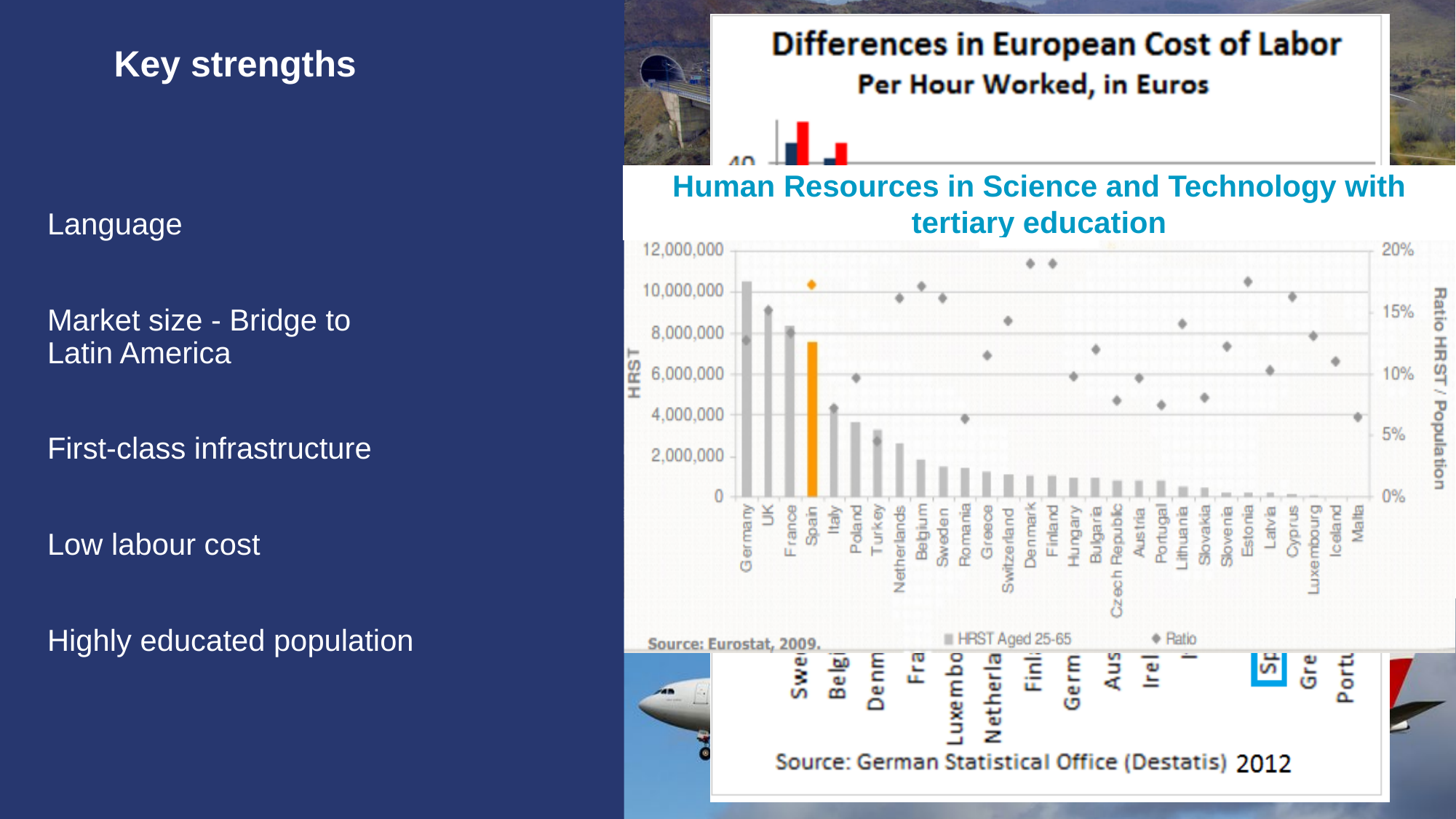
In the 'Human Resources in Science and Technology with tertiary education' chart, is the Ratio value for Denmark greater or less than 15%? greater In the 'Human Resources in Science and Technology with tertiary education' chart, is the HRST bar for Germany greater or less than 10,000,000? greater In the 'Human Resources in Science and Technology with tertiary education' chart, is the HRST bar for Spain greater or less than 8,000,000? less What source is cited below the 'Human Resources in Science and Technology with tertiary education' chart? Eurostat, 2009 In the 'Human Resources in Science and Technology with tertiary education' chart, how many countries are shown on the x axis? 29 In the 'Human Resources in Science and Technology with tertiary education' chart, which country's bar is highlighted in orange? Spain In the 'Human Resources in Science and Technology with tertiary education' chart, how many series does the legend list? 2 In the 'Human Resources in Science and Technology with tertiary education' chart, do the HRST bars rise or fall from left to right along the x axis? fall In the 'Human Resources in Science and Technology with tertiary education' chart, which country has the tallest HRST bar? Germany In the 'Human Resources in Science and Technology with tertiary education' chart, which has the larger HRST bar, Germany or UK? Germany